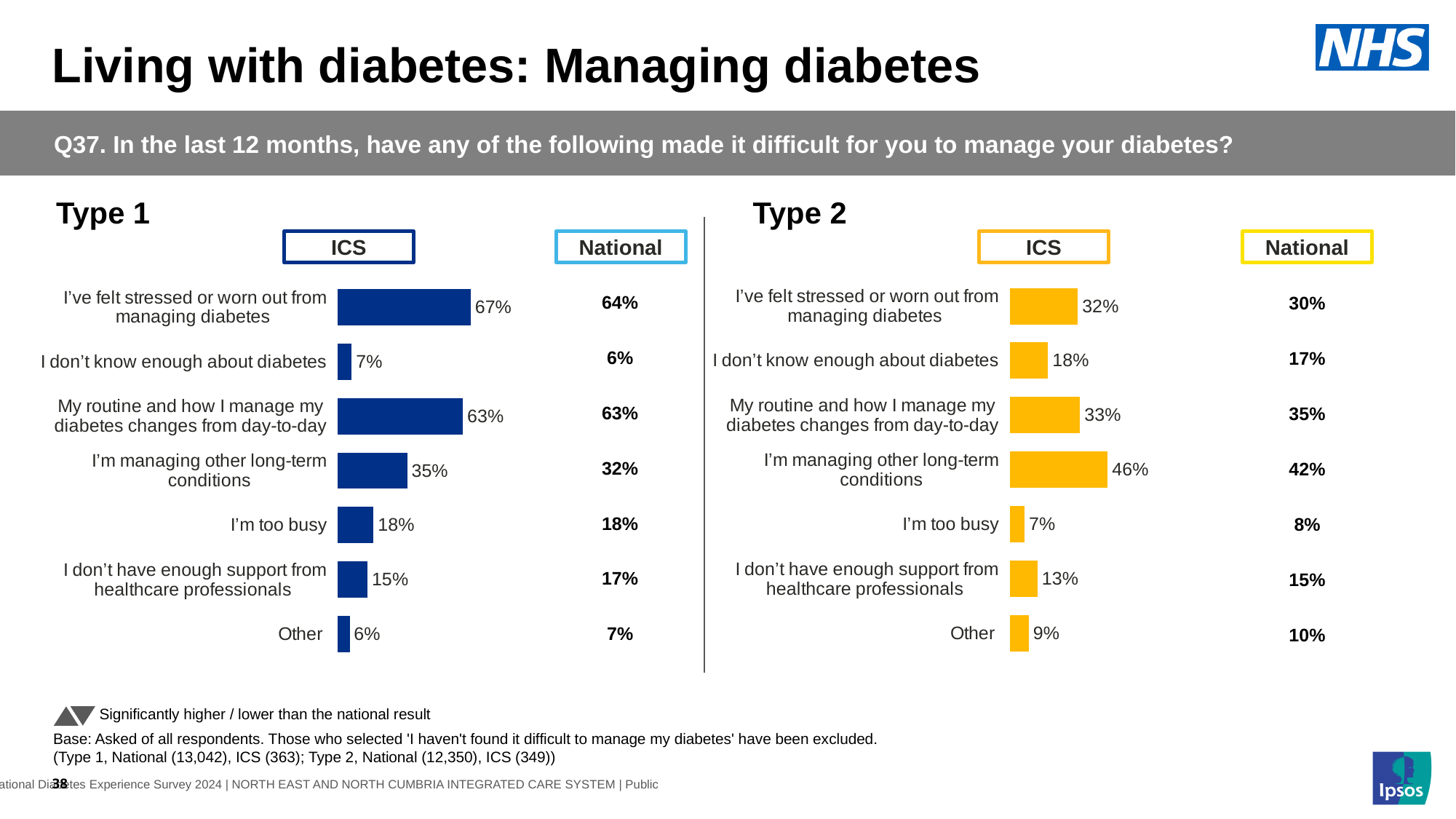
In the Type 2 chart, which is larger for 'My routine and how I manage my diabetes changes from day-to-day': the ICS value or the National value? National In the Type 1 chart, what is the difference between the ICS and National values for 'I'm managing other long-term conditions'? 3 percentage points In the Type 1 chart, what is the National value for 'I'm too busy'? 18% In the Type 2 chart, what is the difference between the ICS and National values for 'Other'? 1 percentage point In the Type 1 chart, which category has the lowest ICS value? Other What colour are the ICS bars in the Type 2 chart? Yellow/orange What kind of chart is used for the ICS values in the Type 1 chart? Bar chart In the Type 2 chart, which category has the highest ICS value? I'm managing other long-term conditions In the Type 1 chart, what is the ICS value for 'I've felt stressed or worn out from managing diabetes'? 67% In the Type 1 chart, which is larger for 'I don't know enough about diabetes': the ICS value or the National value? ICS In the Type 2 chart, what is the ICS value for 'I'm managing other long-term conditions'? 46% How many categories are shown in the Type 2 chart? 7